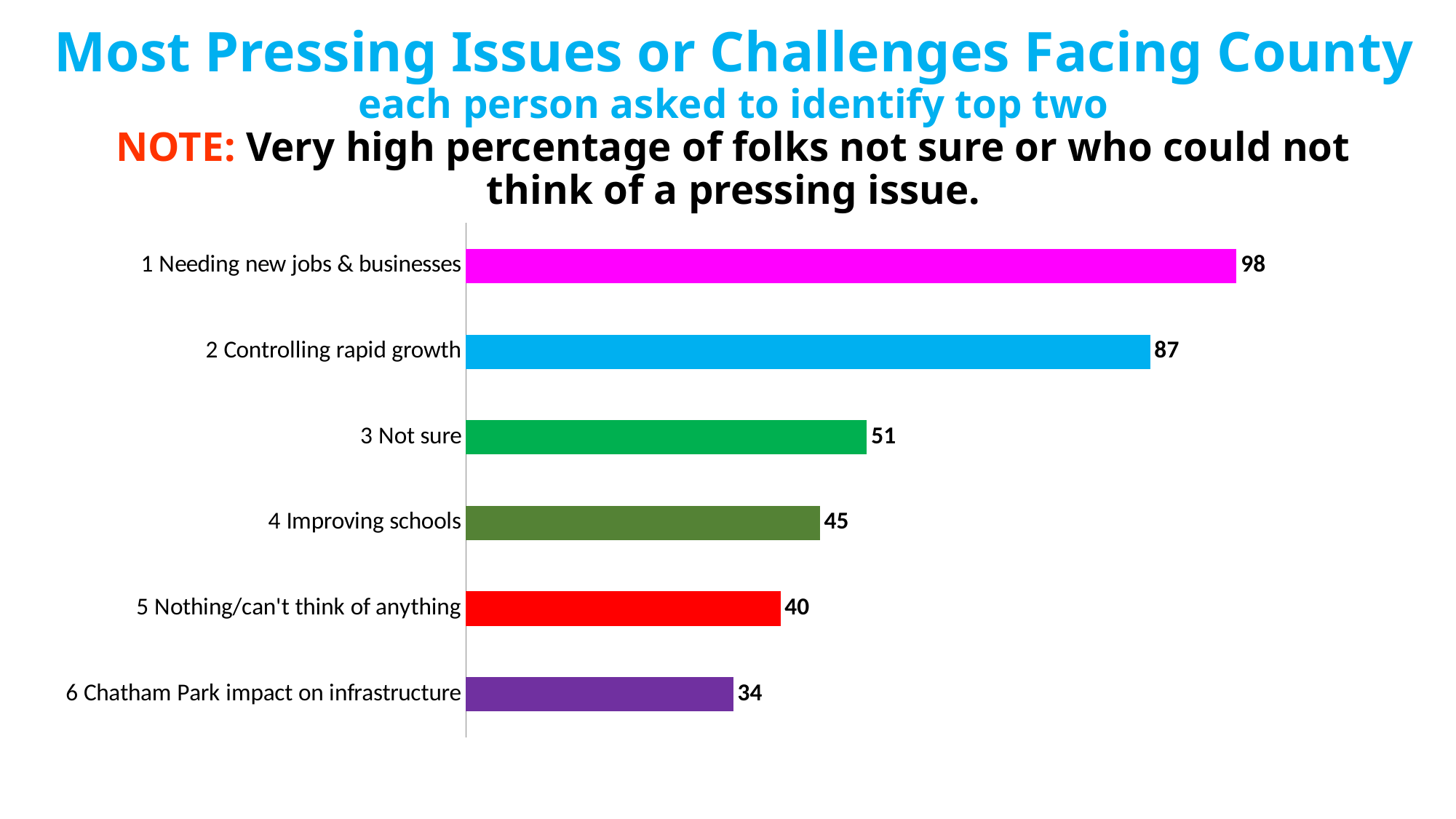
How many categories are shown in the chart? 6 Which category has the highest value? Needing new jobs & businesses What is the value for "Controlling rapid growth"? 87 What is the value for "Not sure"? 51 Which category has the lowest value? Chatham Park impact on infrastructure What is the value for "Chatham Park impact on infrastructure"? 34 Which is larger, the value for "Not sure" or the value for "Improving schools"? Not sure What is the difference between the values for "Improving schools" and "Nothing/can't think of anything"? 5 What colour is the bar for "Nothing/can't think of anything"? Red What is the value for "Needing new jobs & businesses"? 98 What is the difference between the values for "Needing new jobs & businesses" and "Controlling rapid growth"? 11 What kind of chart is shown on the slide? Bar chart